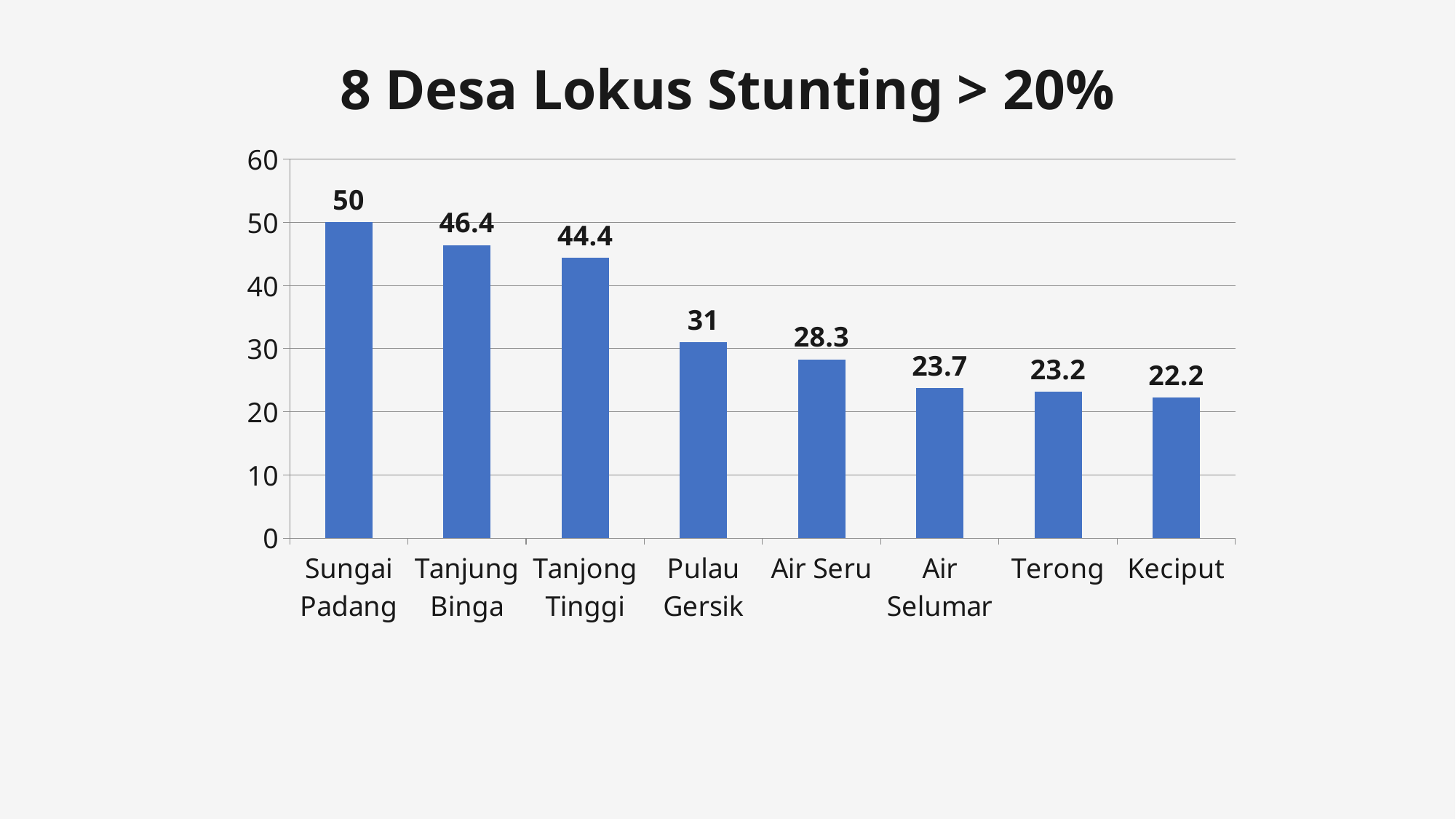
Which village has the lowest value? Keciput What is the title of the chart? 8 Desa Lokus Stunting > 20% What is the difference between the values for Tanjung Binga and Tanjong Tinggi? 2 What is the value for Sungai Padang? 50 Which village has the highest value? Sungai Padang Which is larger, the value for Pulau Gersik or the value for Air Seru? Pulau Gersik What kind of chart is shown on the slide? bar chart What is the value for Keciput? 22.2 How many villages are shown on the chart? 8 What is the difference between the values for Sungai Padang and Pulau Gersik? 19 Is the value for Air Selumar greater or less than 30? less What is the value for Air Seru? 28.3